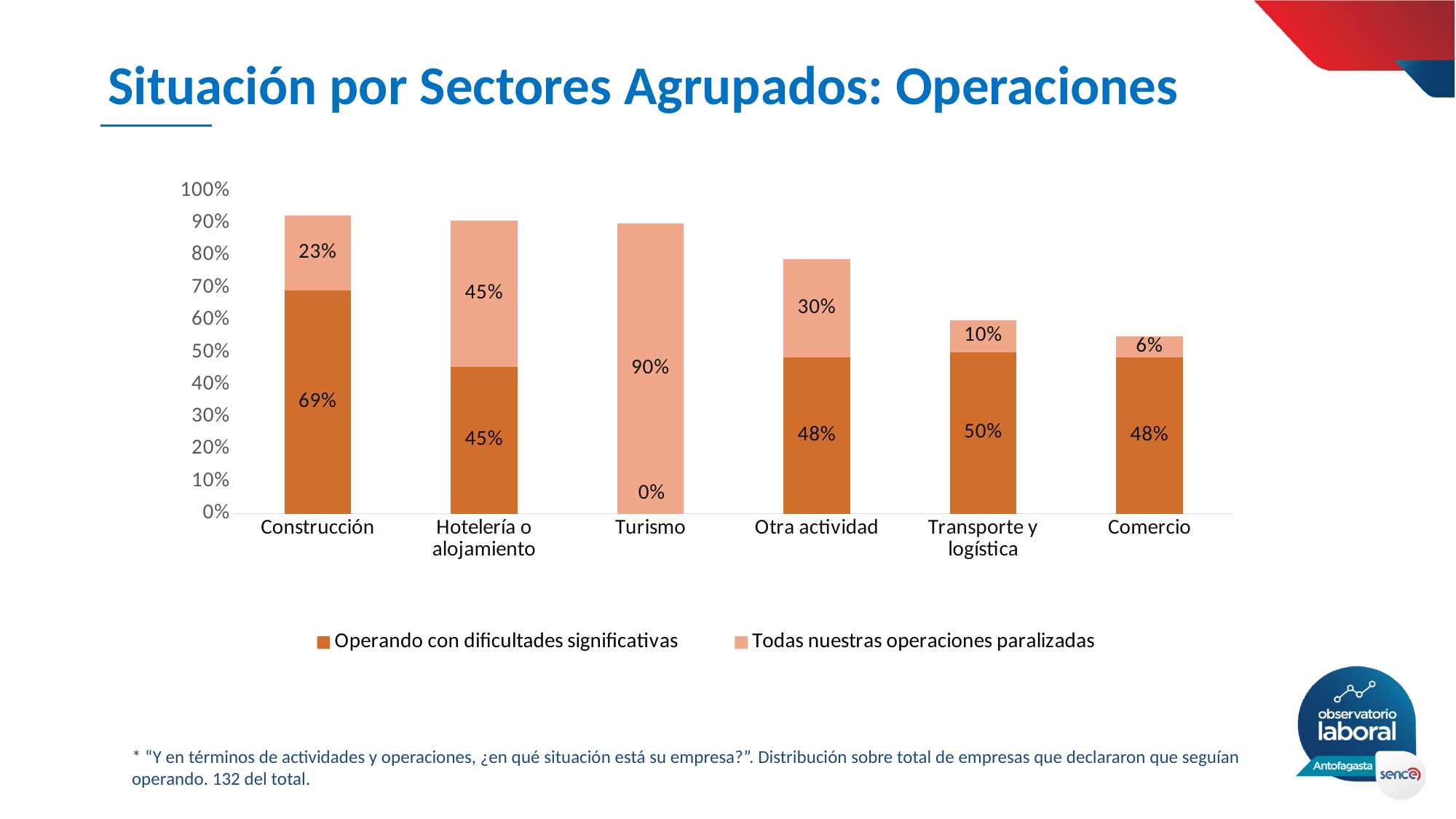
What kind of chart is shown on the slide? Stacked bar chart What is the value of 'Todas nuestras operaciones paralizadas' for Comercio? 6% What is the value of 'Todas nuestras operaciones paralizadas' for Turismo? 90% What is the value of 'Operando con dificultades significativas' for Construcción? 69% What is the total of the stacked bar for Construcción? 92% Which sector has the highest value for 'Operando con dificultades significativas'? Construcción How many sectors (categories) are shown on the x axis? 6 Which sector has the lowest value for 'Todas nuestras operaciones paralizadas'? Comercio Which has a larger value for 'Todas nuestras operaciones paralizadas': Otra actividad or Transporte y logística? Otra actividad How many series does the legend list? 2 Which sector has the lowest value for 'Operando con dificultades significativas'? Turismo What is the difference between the two series values for Construcción (69% and 23%)? 46 percentage points